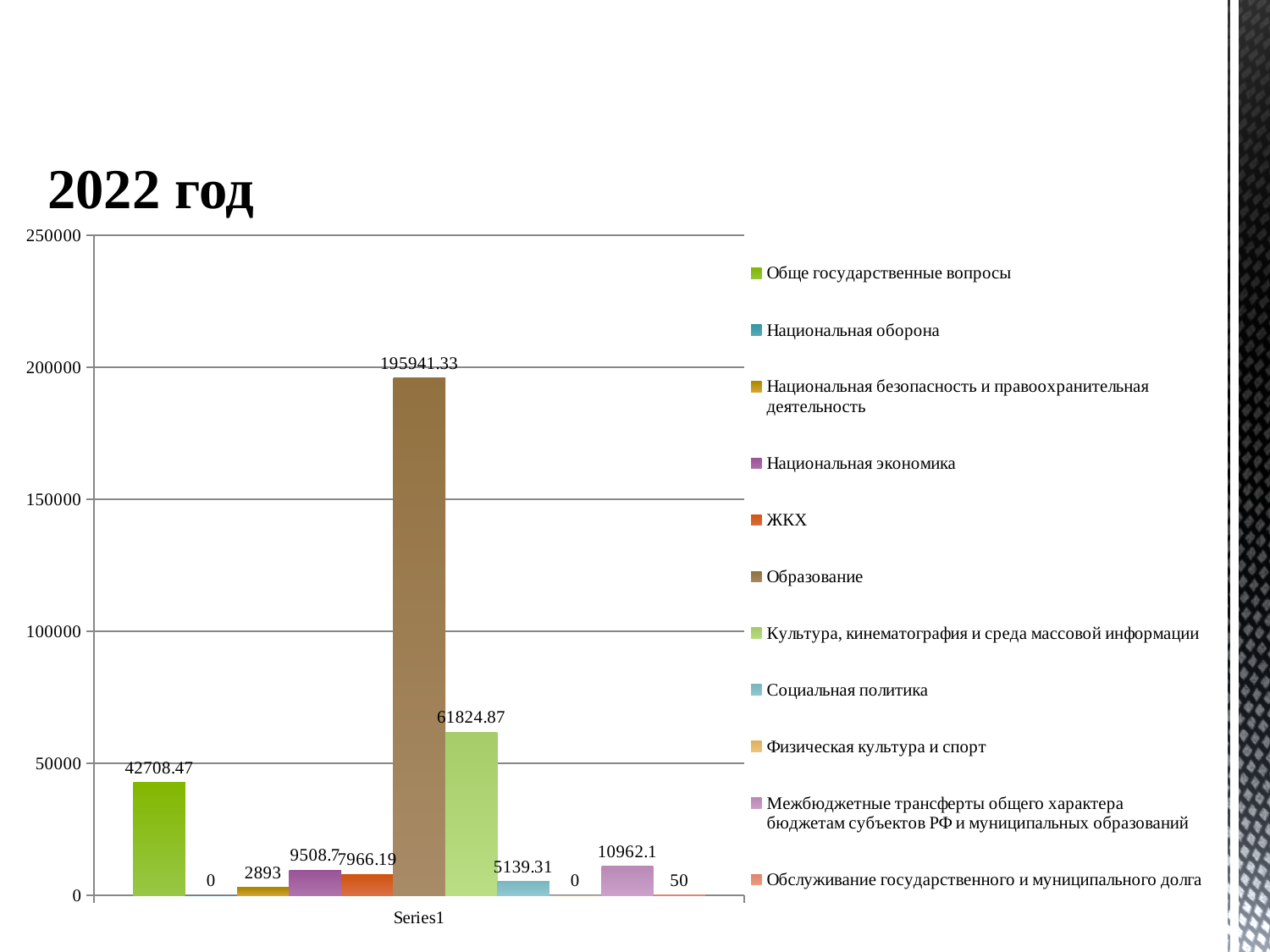
What is the difference between the values for Образование and Культура, кинематография и среда массовой информации? 134116.46 What is the value for Обслуживание государственного и муниципального долга? 50 Which series has the highest value? Образование What is the value for Обще государственные вопросы? 42708.47 What is the value for Межбюджетные трансферты общего характера бюджетам субъектов РФ и муниципальных образований? 10962.1 What is the title of the slide above the chart? 2022 год What is the value for Образование? 195941.33 Is the value for Образование greater or less than 150000? greater Which is larger, the value for Национальная экономика or the value for ЖКХ? Национальная экономика How many series does the legend list? 11 What is the value for Культура, кинематография и среда массовой информации? 61824.87 What kind of chart is shown on the slide? bar chart